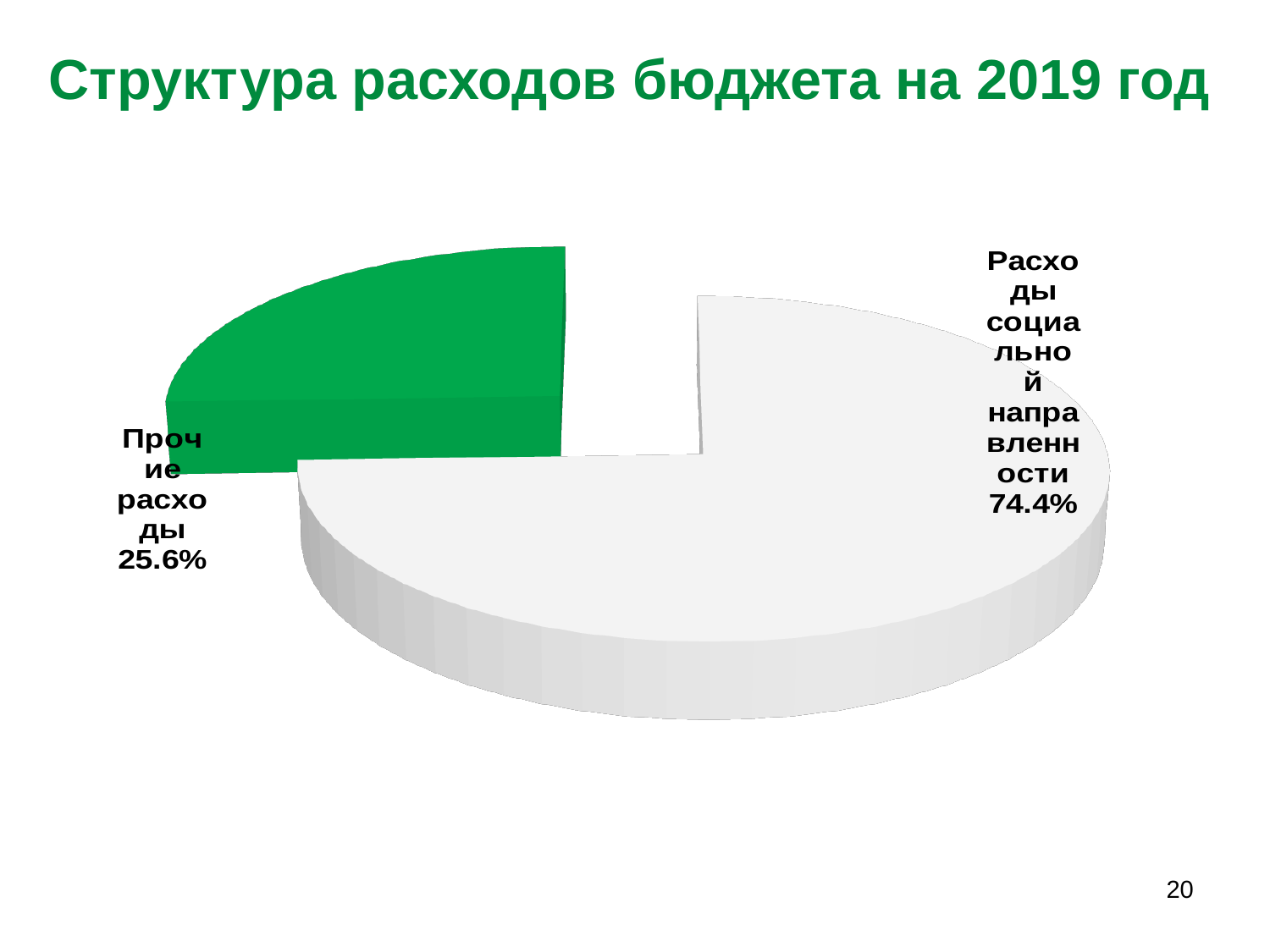
How many slices does the pie chart have? 2 Which is larger: the share for "Прочие расходы" or the share for "Расходы социальной направленности"? Расходы социальной направленности What share of the pie is labelled "Прочие расходы"? 25.6% What colour is the slice for "Прочие расходы"? Green Which slice of the pie is the smallest? Прочие расходы Is the share for "Прочие расходы" greater or less than 50%? less What share of the pie is labelled "Расходы социальной направленности"? 74.4% What is the title of the slide? Структура расходов бюджета на 2019 год What is the difference in percentage points between "Расходы социальной направленности" and "Прочие расходы"? 48.8 Which slice of the pie is the largest? Расходы социальной направленности What kind of chart is shown on the slide? Pie chart